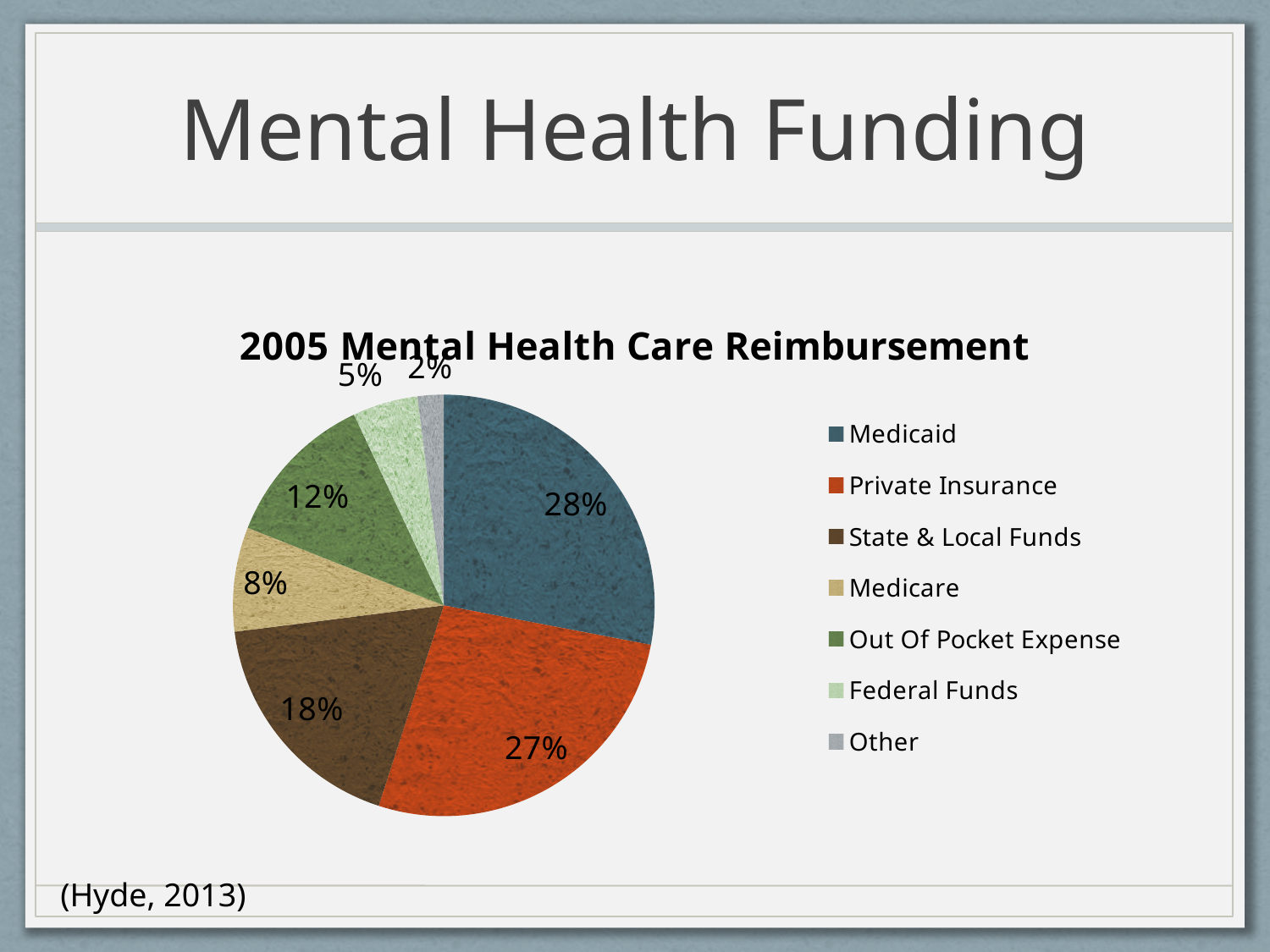
Which category has the smallest share of the pie? Other What percentage is shown for Private Insurance? 27% Which category has the largest share of the pie? Medicaid What share of the pie does Medicaid account for? 28% What percentage is shown for Out Of Pocket Expense? 12% What type of chart is shown on the slide? pie chart What percentage is shown for Medicare? 8% Which is larger, Out Of Pocket Expense or Federal Funds? Out Of Pocket Expense How many categories does the legend list? 7 What percentage is shown for State & Local Funds? 18% What is the title of the chart? 2005 Mental Health Care Reimbursement What is the difference in percentage points between State & Local Funds and Medicare? 10